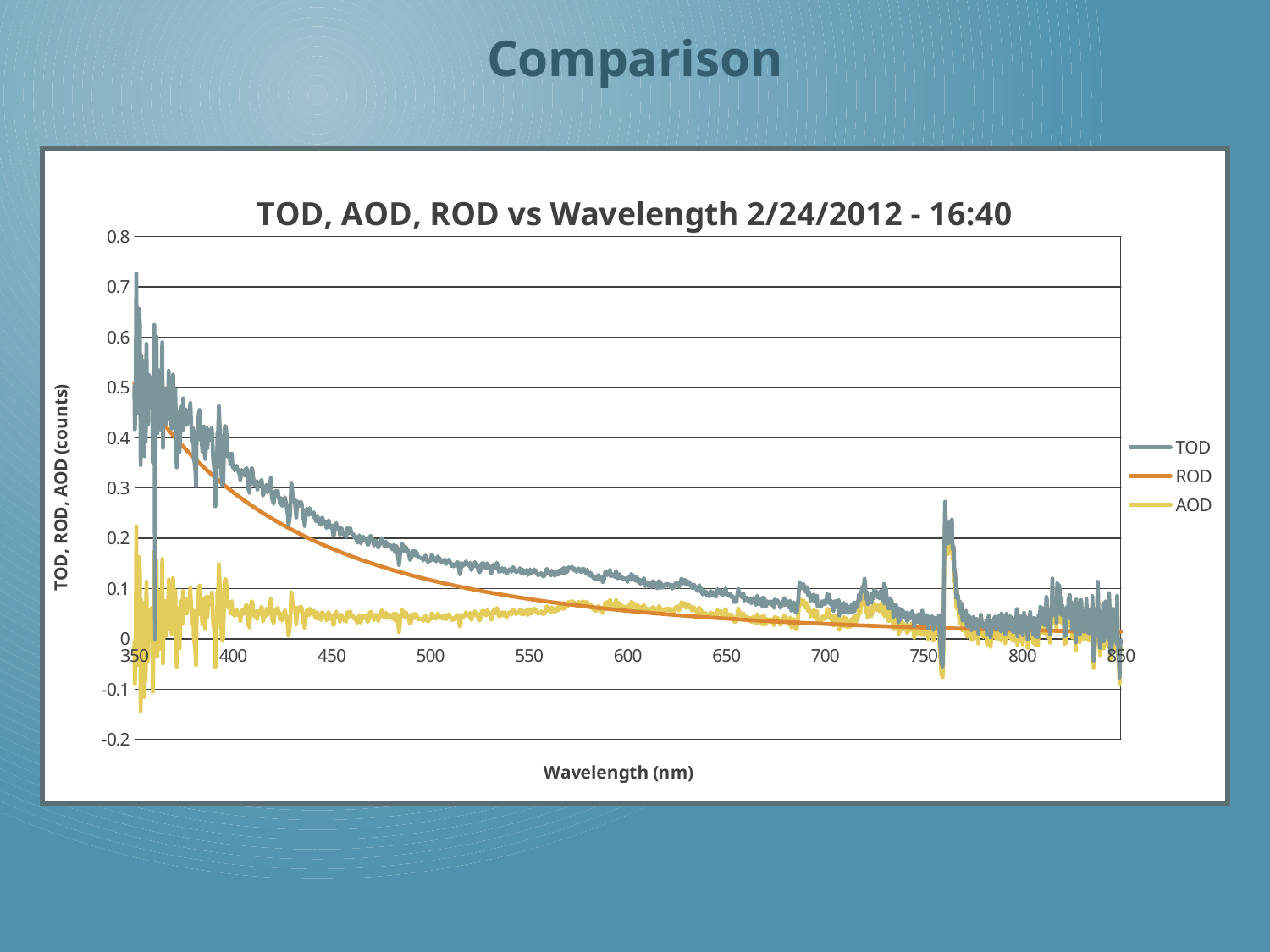
What kind of chart is shown on the slide? line chart At 500 nm, which series has the larger value, TOD or ROD? TOD At 450 nm, which series has the larger value, ROD or AOD? ROD Is the value of TOD at 600 nm greater or less than 0.1? greater Which series reaches the highest value on the chart? TOD How many series does the legend list? 3 What is the title of the chart? TOD, AOD, ROD vs Wavelength 2/24/2012 - 16:40 Is the value of AOD at 500 nm greater or less than 0.1? less Is the value of ROD at 500 nm greater or less than 0.2? less What is the label of the x axis? Wavelength (nm) Does the ROD series rise or fall as wavelength increases from 350 nm to 850 nm? fall